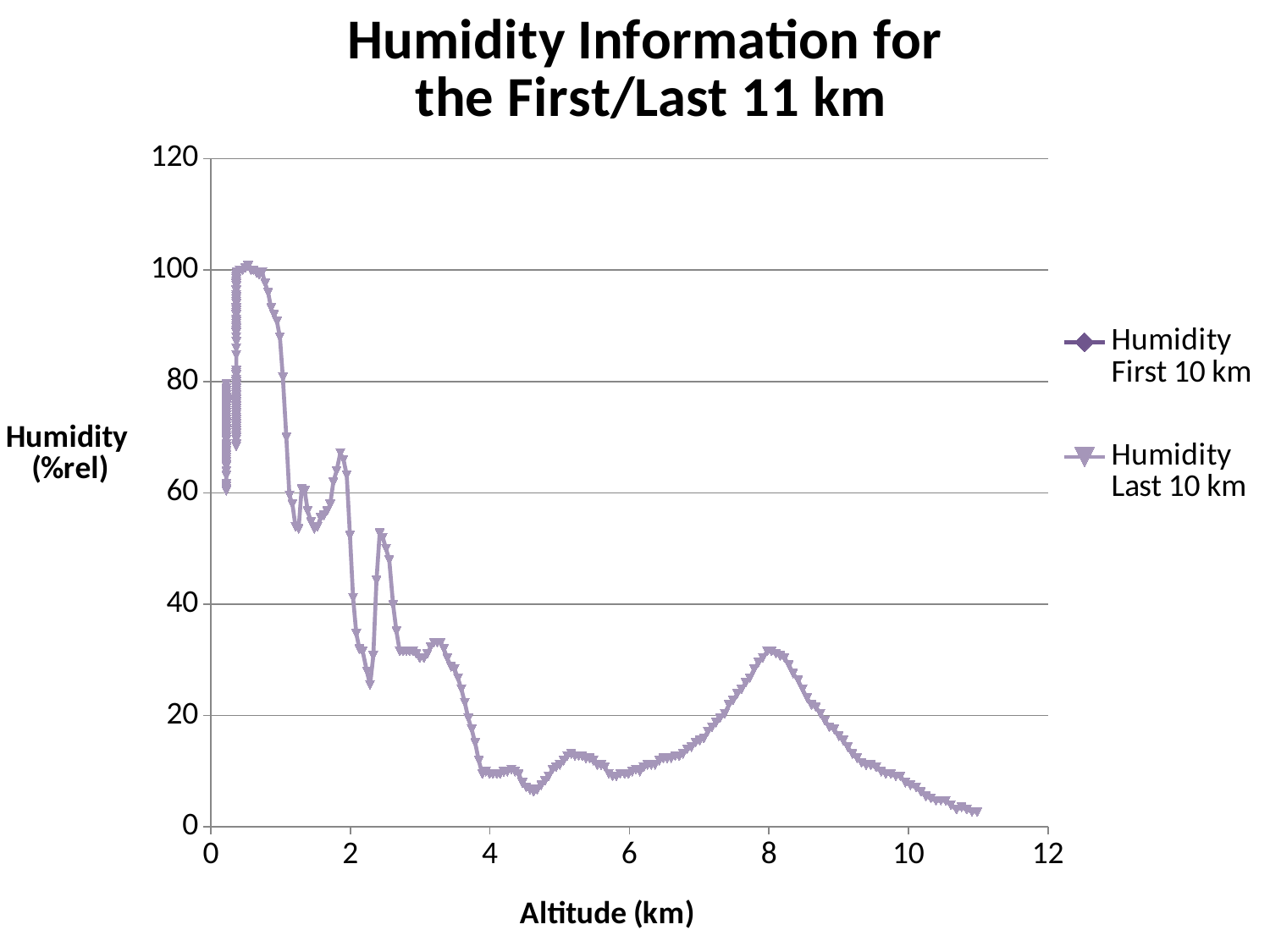
What kind of chart is shown on the slide? line chart How many series does the legend list? 2 Is the value of the Humidity Last 10 km series at an altitude of 4 km greater or less than 20? less Is the value of the Humidity Last 10 km series at an altitude of 8 km greater or less than 20? greater Is the highest value of the Humidity Last 10 km series greater or less than 80? greater Does the Humidity Last 10 km series rise or fall between altitudes of 8 km and 11 km? fall What is the label of the x axis? Altitude (km) What is the title of the chart? Humidity Information for the First/Last 11 km For the Humidity Last 10 km series, is the humidity larger at an altitude of 8 km or at 10 km? 8 km Does the Humidity Last 10 km series rise or fall between altitudes of 6 km and 8 km? rise